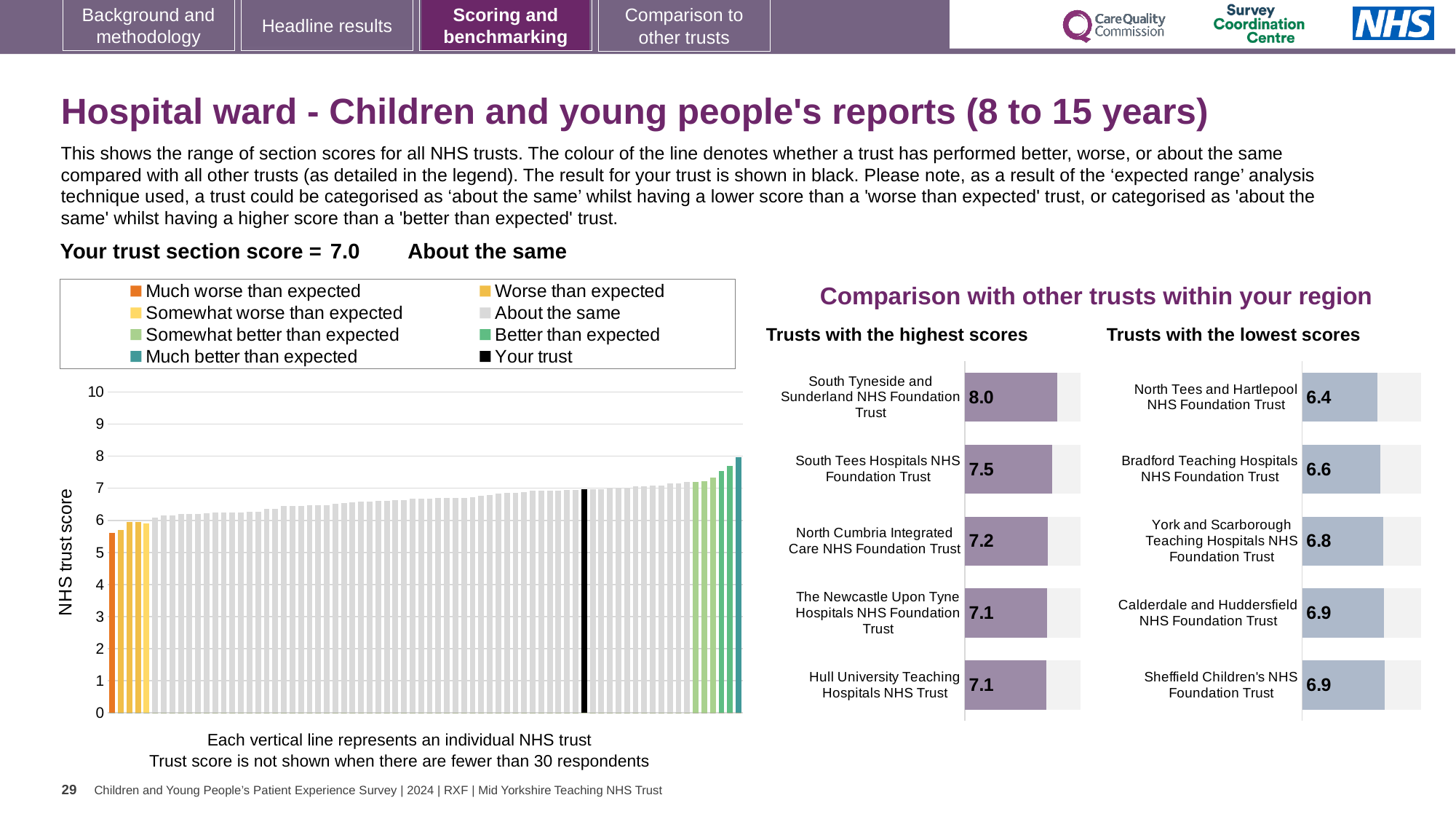
In the NHS trust score chart on the left, do the bar values rise or fall from left to right? rise In the 'Trusts with the highest scores' chart, which trust has the highest score? South Tyneside and Sunderland NHS Foundation Trust In the NHS trust score chart on the left, is the value of the tallest bar greater or less than 7? greater In the NHS trust score chart on the left, what is the section score for your trust (the black bar)? 7.0 How many entries does the legend of the NHS trust score chart on the left list? 8 In the 'Trusts with the highest scores' chart, what is the difference between the scores of South Tyneside and Sunderland NHS Foundation Trust and South Tees Hospitals NHS Foundation Trust? 0.5 In the 'Trusts with the highest scores' chart, which has the larger score: North Cumbria Integrated Care NHS Foundation Trust or The Newcastle Upon Tyne Hospitals NHS Foundation Trust? North Cumbria Integrated Care NHS Foundation Trust In the 'Trusts with the lowest scores' chart, how many trusts are shown? 5 In the 'Trusts with the lowest scores' chart, what is the difference between the scores of Bradford Teaching Hospitals NHS Foundation Trust and North Tees and Hartlepool NHS Foundation Trust? 0.2 In the 'Trusts with the lowest scores' chart, which trust has the lowest score? North Tees and Hartlepool NHS Foundation Trust In the 'Trusts with the highest scores' chart, what is the score for South Tyneside and Sunderland NHS Foundation Trust? 8.0 In the 'Trusts with the lowest scores' chart, what is the score for North Tees and Hartlepool NHS Foundation Trust? 6.4